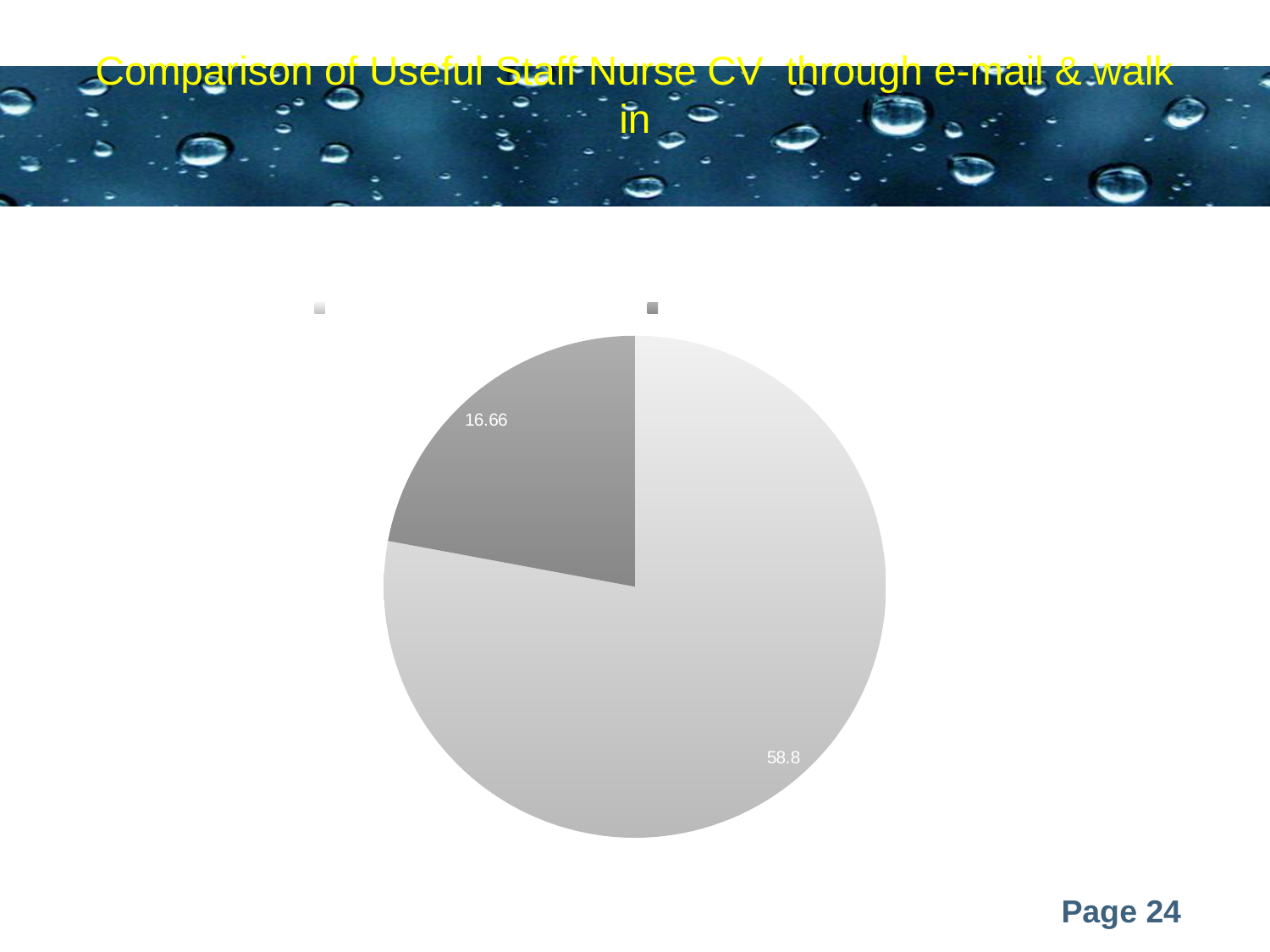
What is the title of the slide containing the pie chart? Comparison of Useful Staff Nurse CV through e-mail & walk in What value is labelled on the lighter grey slice of the pie chart? 58.8 What is the value of the largest slice in the pie chart? 58.8 Is the value of the lighter grey slice greater or less than 50? greater What kind of chart is shown on the slide? pie chart Which slice is larger, the one labelled 58.8 or the one labelled 16.66? 58.8 What is the difference between the two slice values in the pie chart? 42.14 Is the value of the darker grey slice greater or less than 20? less How many slices does the pie chart have? 2 How many entries does the legend above the pie chart show? 2 What value is labelled on the darker grey slice of the pie chart? 16.66 What is the value of the smallest slice in the pie chart? 16.66